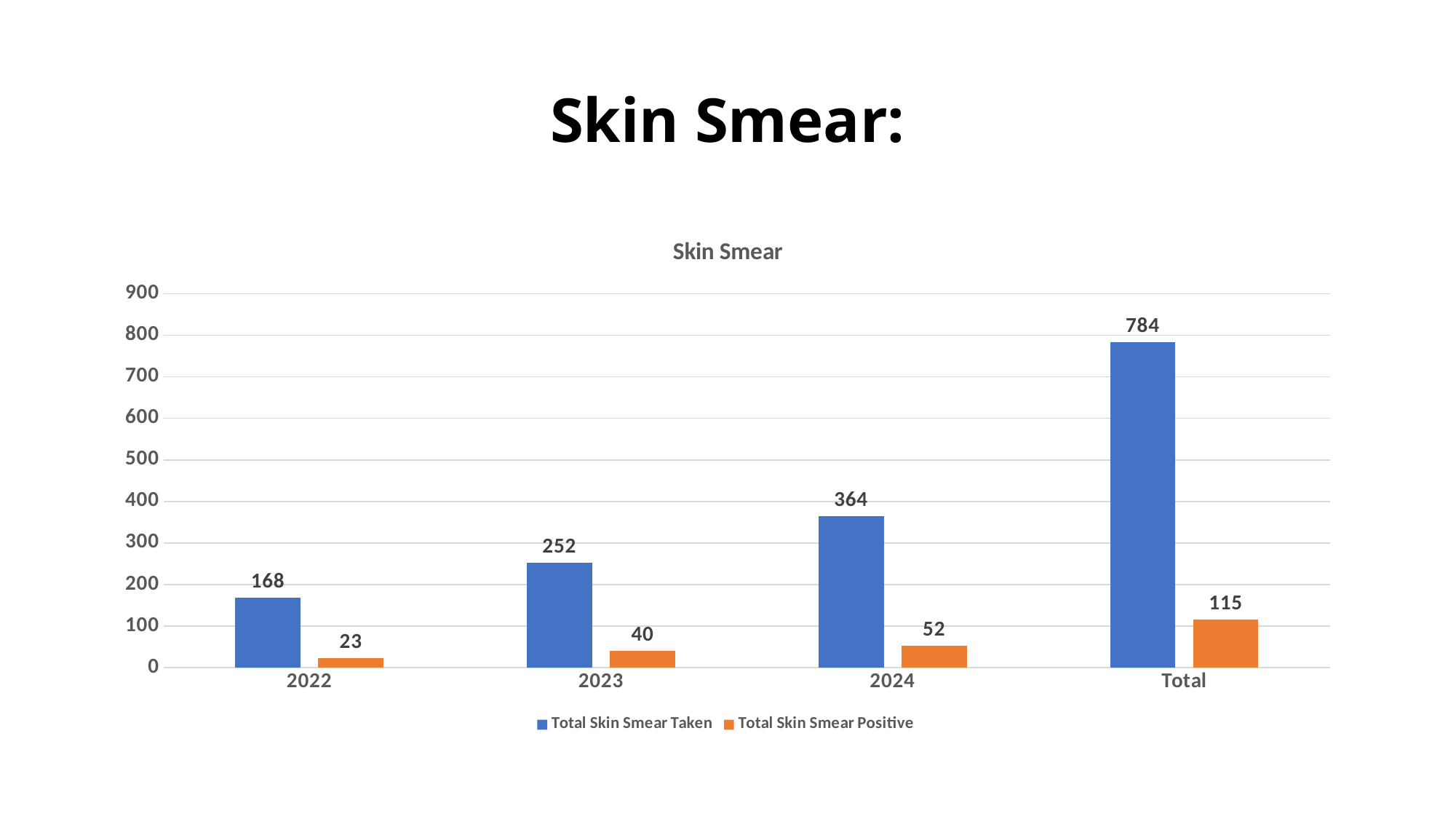
How many series does the legend list? 2 How many categories are shown on the x axis? 4 Which category has the lowest Total Skin Smear Positive value? 2022 What is the value of Total Skin Smear Positive for 2024? 52 What is the difference between Total Skin Smear Taken and Total Skin Smear Positive in 2022? 145 Is the Total Skin Smear Taken value for the Total category greater or less than 700? greater How much higher is Total Skin Smear Taken in 2024 than in 2023? 112 What kind of chart is shown on the slide? Bar chart Which is larger: Total Skin Smear Positive in 2023 or in 2024? 2024 Among the years 2022, 2023 and 2024, which has the highest Total Skin Smear Taken? 2024 What is the value of Total Skin Smear Taken for 2023? 252 What is the value of Total Skin Smear Positive for the Total category? 115